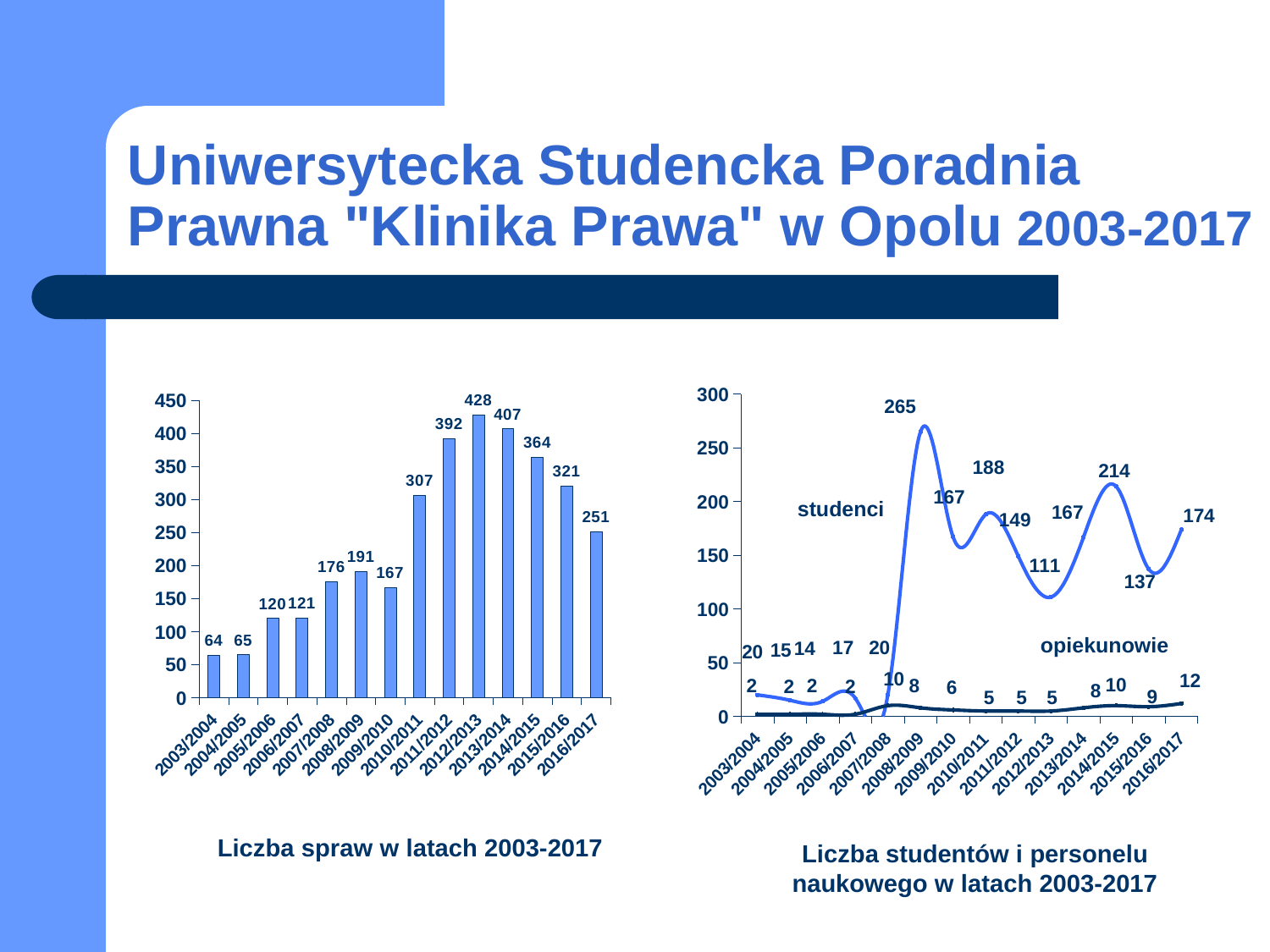
In the chart 'Liczba studentów i personelu naukowego w latach 2003-2017', which year has the highest value for studenci? 2008/2009 In the chart 'Liczba spraw w latach 2003-2017', what is the difference between the values for 2011/2012 and 2010/2011? 85 In the chart 'Liczba spraw w latach 2003-2017', which year has the highest value? 2012/2013 In the chart 'Liczba spraw w latach 2003-2017', how many years are shown on the x axis? 14 What kind of chart is 'Liczba studentów i personelu naukowego w latach 2003-2017'? line chart In the chart 'Liczba spraw w latach 2003-2017', what is the value for 2012/2013? 428 How many series are plotted in the chart 'Liczba studentów i personelu naukowego w latach 2003-2017'? 2 In the chart 'Liczba spraw w latach 2003-2017', which year has the lowest value? 2003/2004 What kind of chart is 'Liczba spraw w latach 2003-2017'? bar chart In the chart 'Liczba studentów i personelu naukowego w latach 2003-2017', which is larger: the studenci value for 2014/2015 or for 2015/2016? 2014/2015 In the chart 'Liczba studentów i personelu naukowego w latach 2003-2017', what is the value for studenci in 2008/2009? 265 In the chart 'Liczba studentów i personelu naukowego w latach 2003-2017', what is the value for opiekunowie in 2016/2017? 12